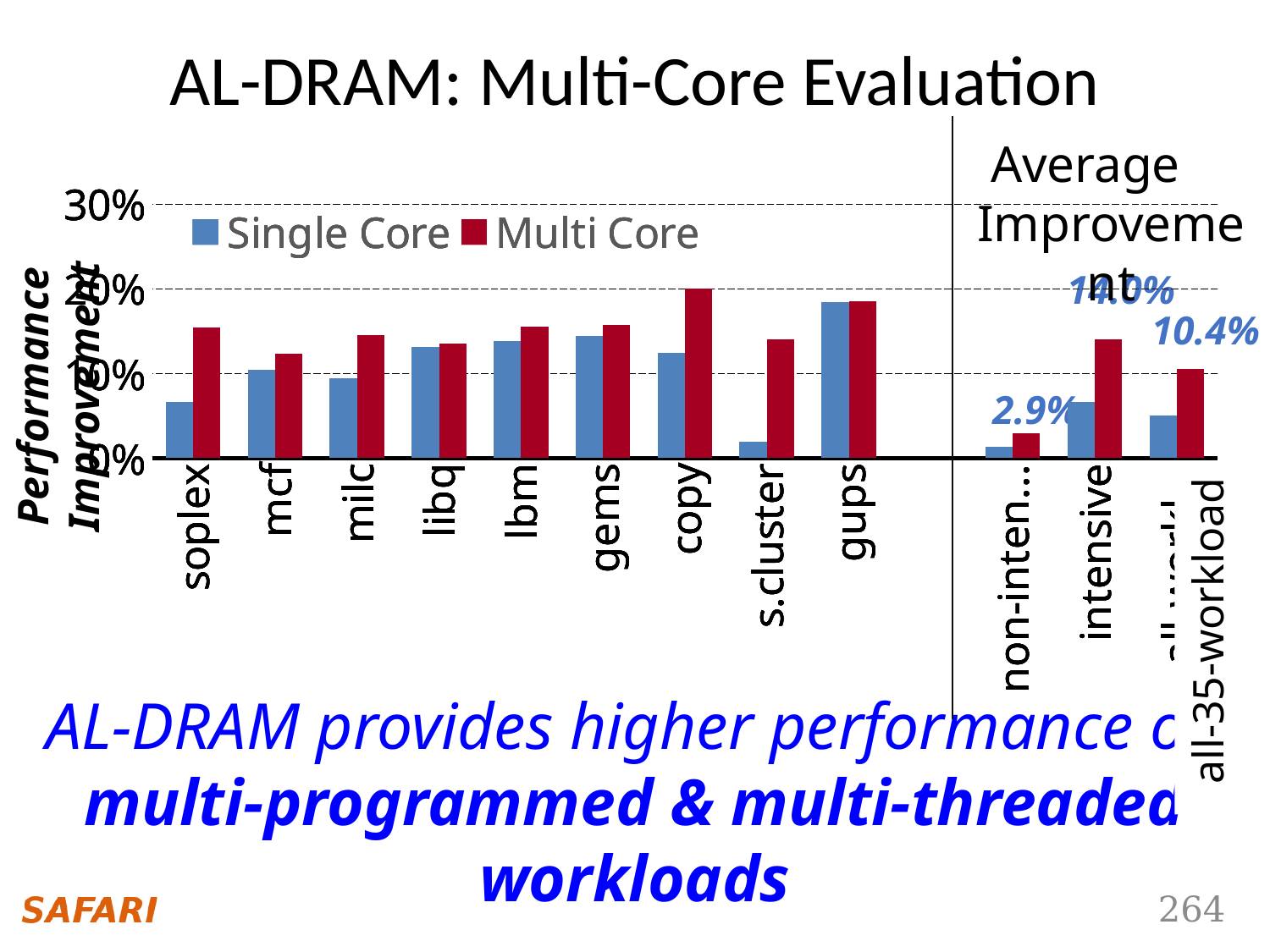
What is the Multi Core performance improvement for the non-intensive workload group? 2.9% Which category has the highest Multi Core performance improvement? copy What kind of chart is shown on the slide? bar chart Is the Single Core value for s.cluster greater or less than 10%? less For soplex, which is larger: the Single Core or the Multi Core improvement? Multi Core Which category has the lowest Multi Core performance improvement? non-intensive What are the two series named in the legend? Single Core and Multi Core What is the Multi Core performance improvement for all-35-workload? 10.4% What is the difference between the Multi Core improvement for all-35-workload and for the non-intensive group? 7.5% How many series does the legend list? 2 Is the Single Core value for copy greater or less than 10%? greater Which category has the highest Single Core performance improvement? gups